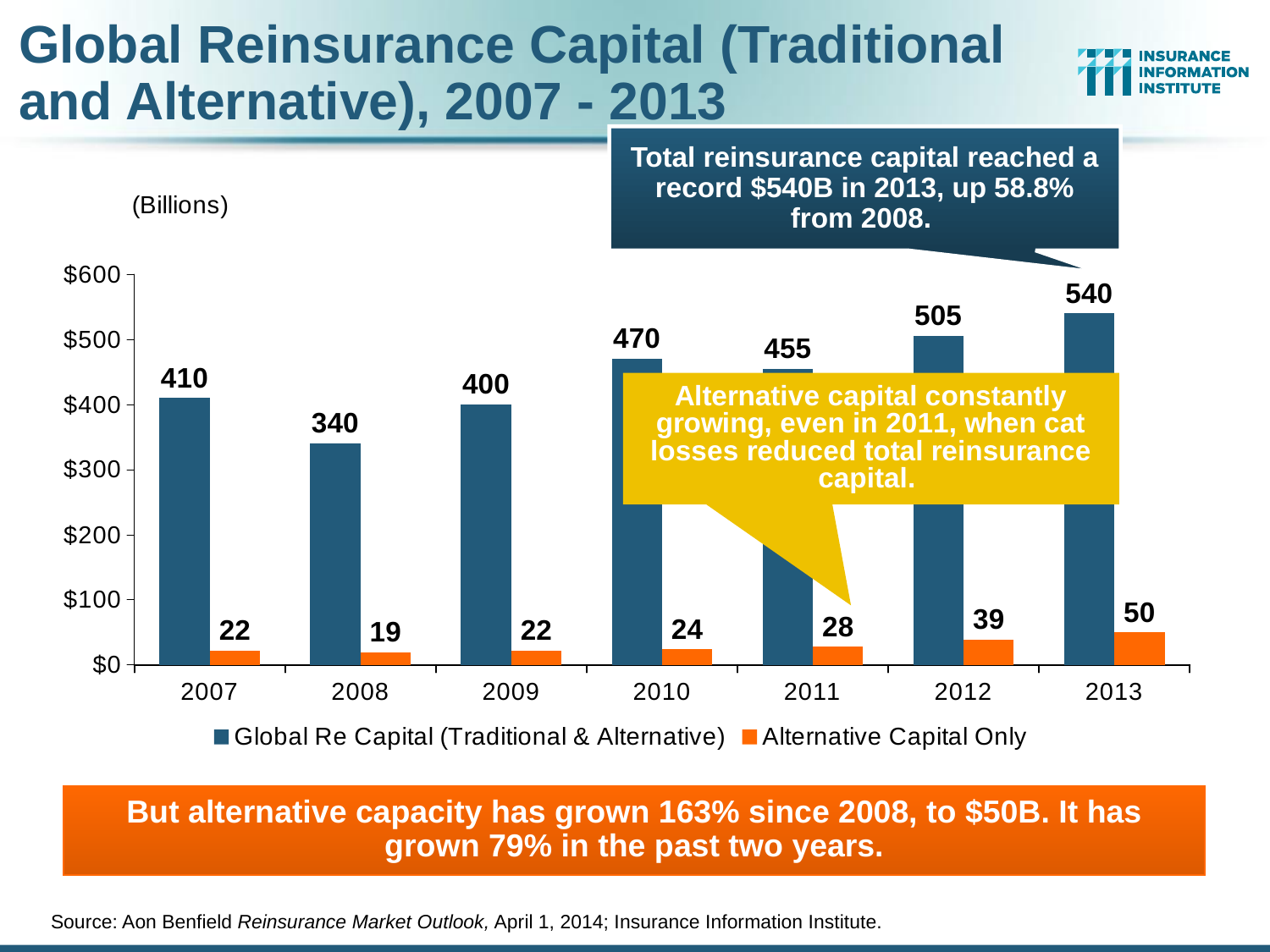
Did Alternative Capital Only rise or fall from 2009 to 2013? Rise What was Alternative Capital Only in 2012? 39 In which year was Alternative Capital Only highest? 2013 What was Global Re Capital (Traditional & Alternative) in 2010? 470 Which year had higher Global Re Capital (Traditional & Alternative), 2010 or 2011? 2010 What is the difference between Global Re Capital in 2013 and in 2008? 200 In which year was Global Re Capital (Traditional & Alternative) lowest? 2008 What unit is indicated above the chart's y axis? Billions How many years are shown on the x axis of the chart? 7 What type of chart is shown on the slide? Bar chart How many series does the legend list? 2 What is the difference between Alternative Capital Only in 2013 and in 2011? 22